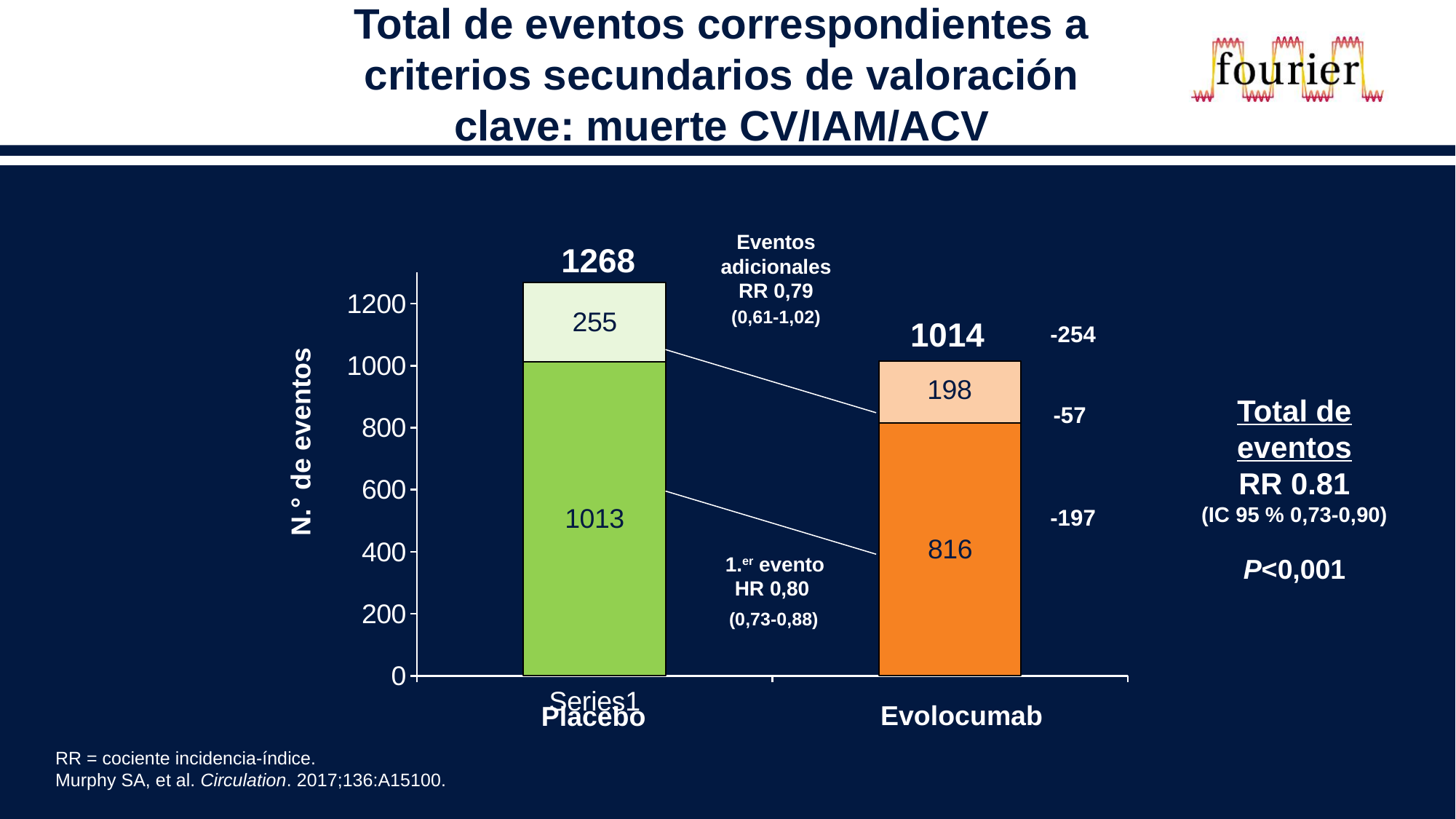
How many additional events (top segment) are shown for Placebo? 255 What is the difference in first events between Placebo and Evolocumab? 197 What is the total number of events for the Placebo bar? 1268 How many first events (bottom segment) are shown for Placebo? 1013 What is the difference in total events between Placebo and Evolocumab? 254 Which group has the higher total number of events? Placebo How many additional events (top segment) are shown for Evolocumab? 198 What is the total number of events for the Evolocumab bar? 1014 What type of chart is shown on the slide? Stacked bar chart Which is larger, the additional events for Placebo or for Evolocumab? Placebo How many groups (bars) are shown on the chart? 2 How many first events (bottom segment) are shown for Evolocumab? 816